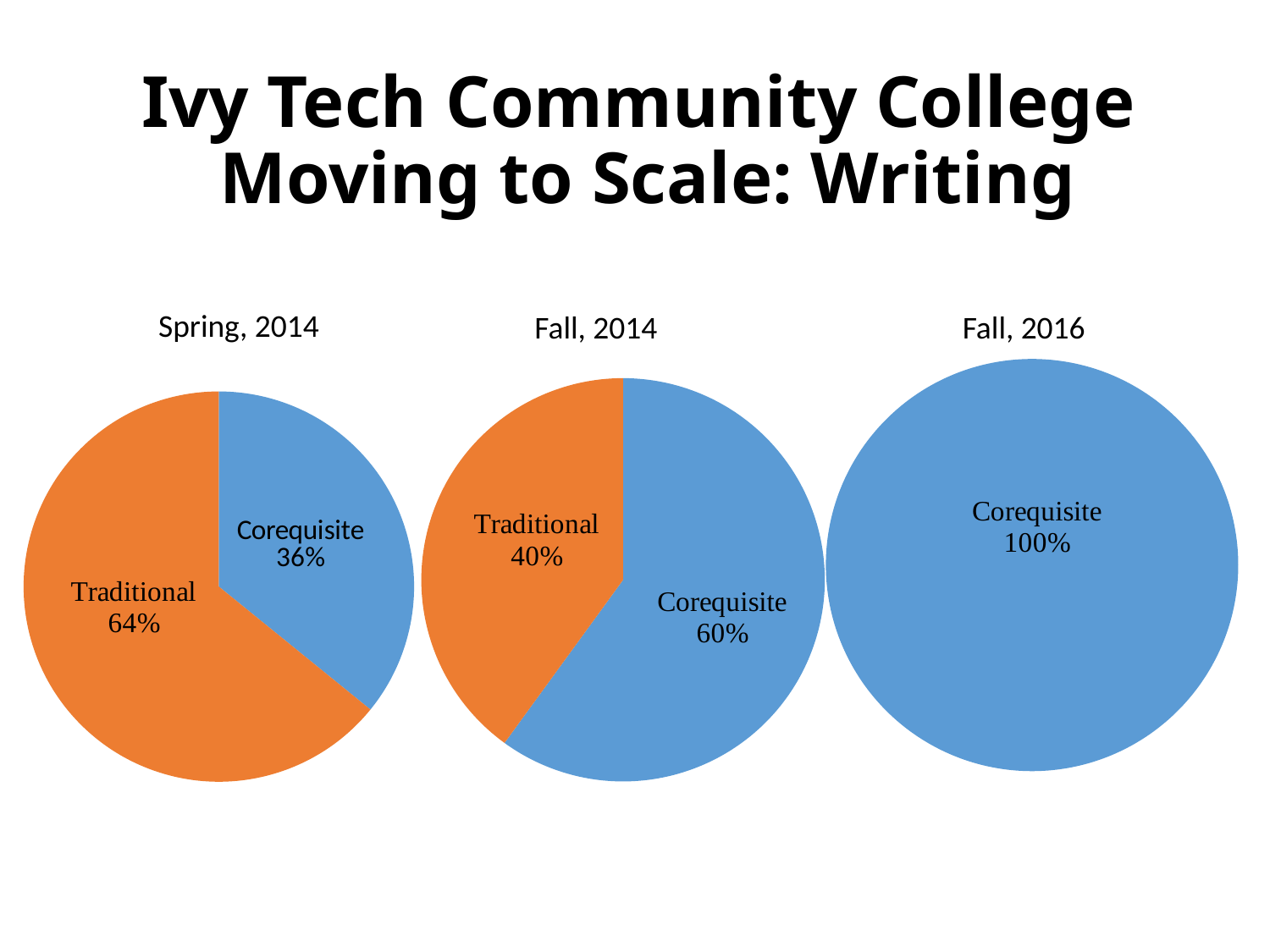
In the Spring, 2014 chart, what share does Corequisite have? 36% In the Fall, 2014 chart, what share does Corequisite have? 60% In the Spring, 2014 chart, which is larger, Corequisite or Traditional? Traditional In the Fall, 2014 chart, which slice is the smallest? Traditional In the Fall, 2016 chart, what share does Corequisite have? 100% In the Spring, 2014 chart, which slice is the largest? Traditional What kind of chart is the Fall, 2014 chart? Pie chart In the Fall, 2014 chart, what is the difference between the Corequisite and Traditional shares? 20% How many pie charts are shown on the slide? 3 How many slices does the Spring, 2014 chart have? 2